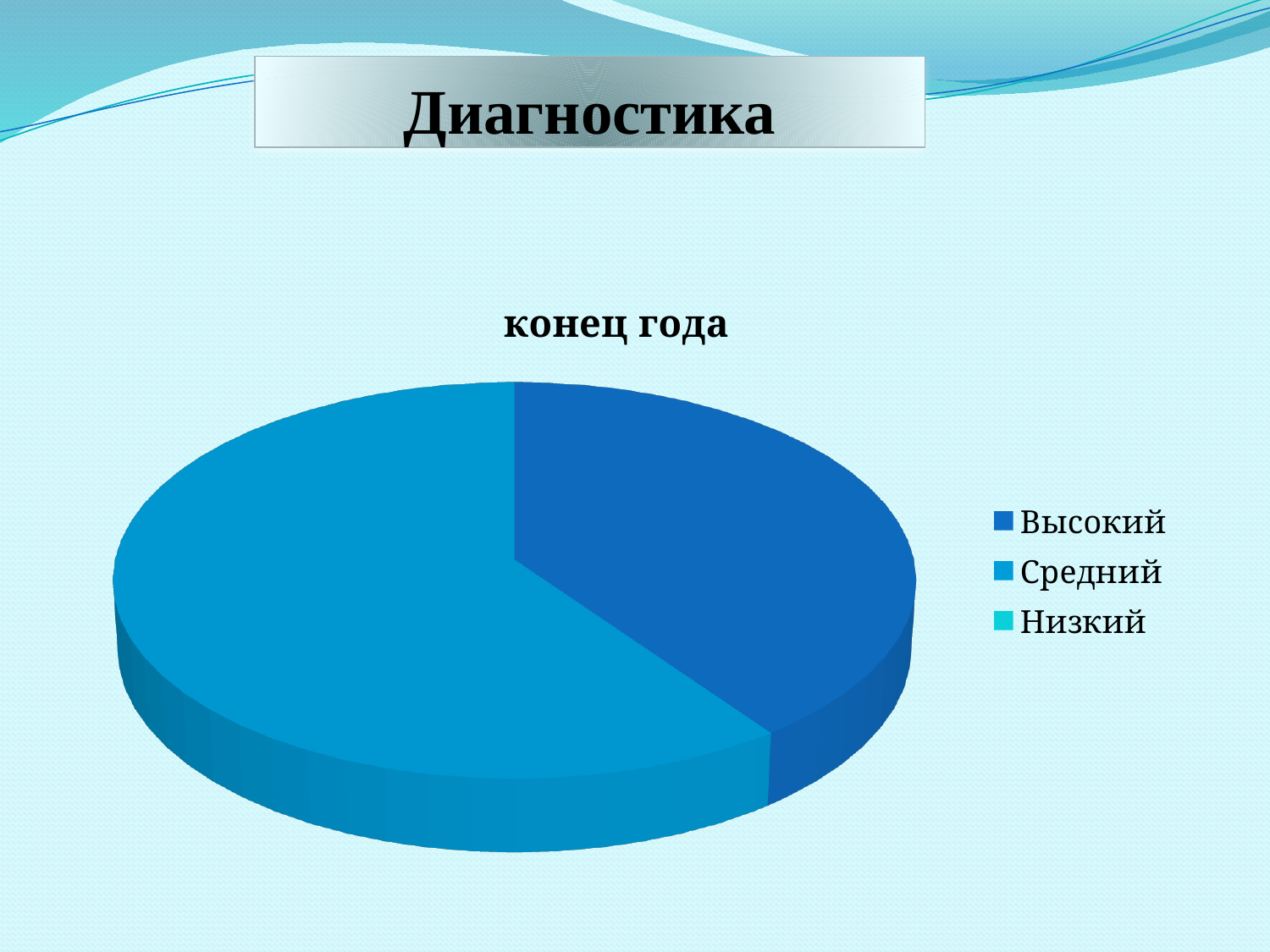
How many entries does the chart's legend list? 3 Which legend entry is listed first in the chart's legend? Высокий What is the title of the chart? конец года Which slice is larger, Высокий or Средний? Средний Does the Высокий slice take up more or less than half of the pie? less Does the Средний slice take up more or less than half of the pie? more Which category has the largest slice of the pie? Средний What kind of chart is shown on the slide? pie chart